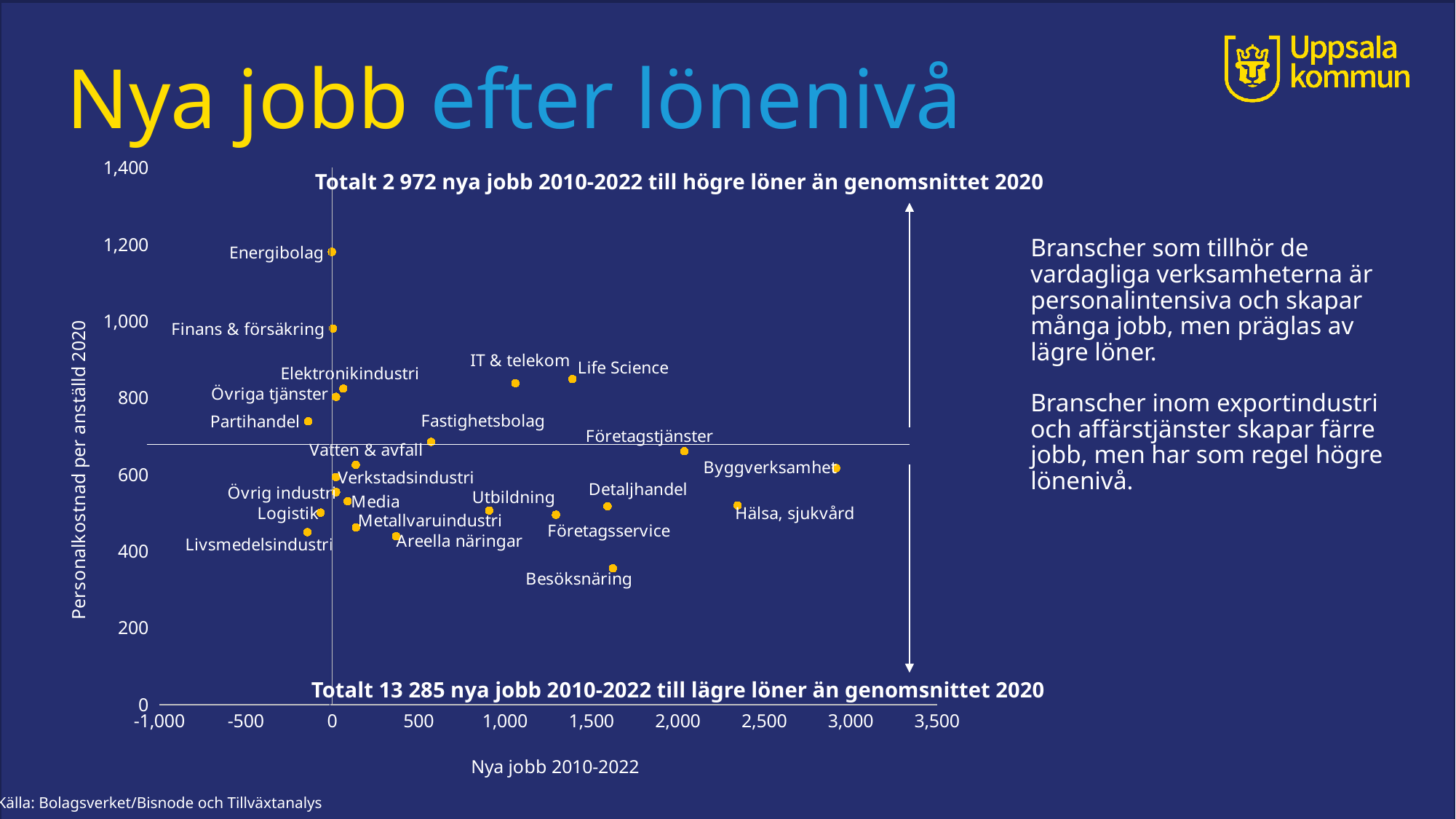
Is the number of new jobs 2010-2022 for Partihandel greater or less than 0? less What kind of chart is shown on the slide? Scatter chart Which has a higher personnel cost per employee, Energibolag or Finans & försäkring? Energibolag How many industries (data points) are plotted in the chart? 23 Which industry has the highest number of new jobs 2010-2022 (furthest right on the x axis)? Byggverksamhet Which industry has the lowest personnel cost per employee in the chart? Besöksnäring What is the title of the x axis of the chart? Nya jobb 2010-2022 Which has more new jobs 2010-2022, Byggverksamhet or Hälsa, sjukvård? Byggverksamhet Is the personnel cost per employee for Energibolag greater or less than 1,000? greater Which industry has the highest personnel cost per employee (Personalkostnad per anställd 2020) in the chart? Energibolag Is the personnel cost per employee for Besöksnäring greater or less than 400? less